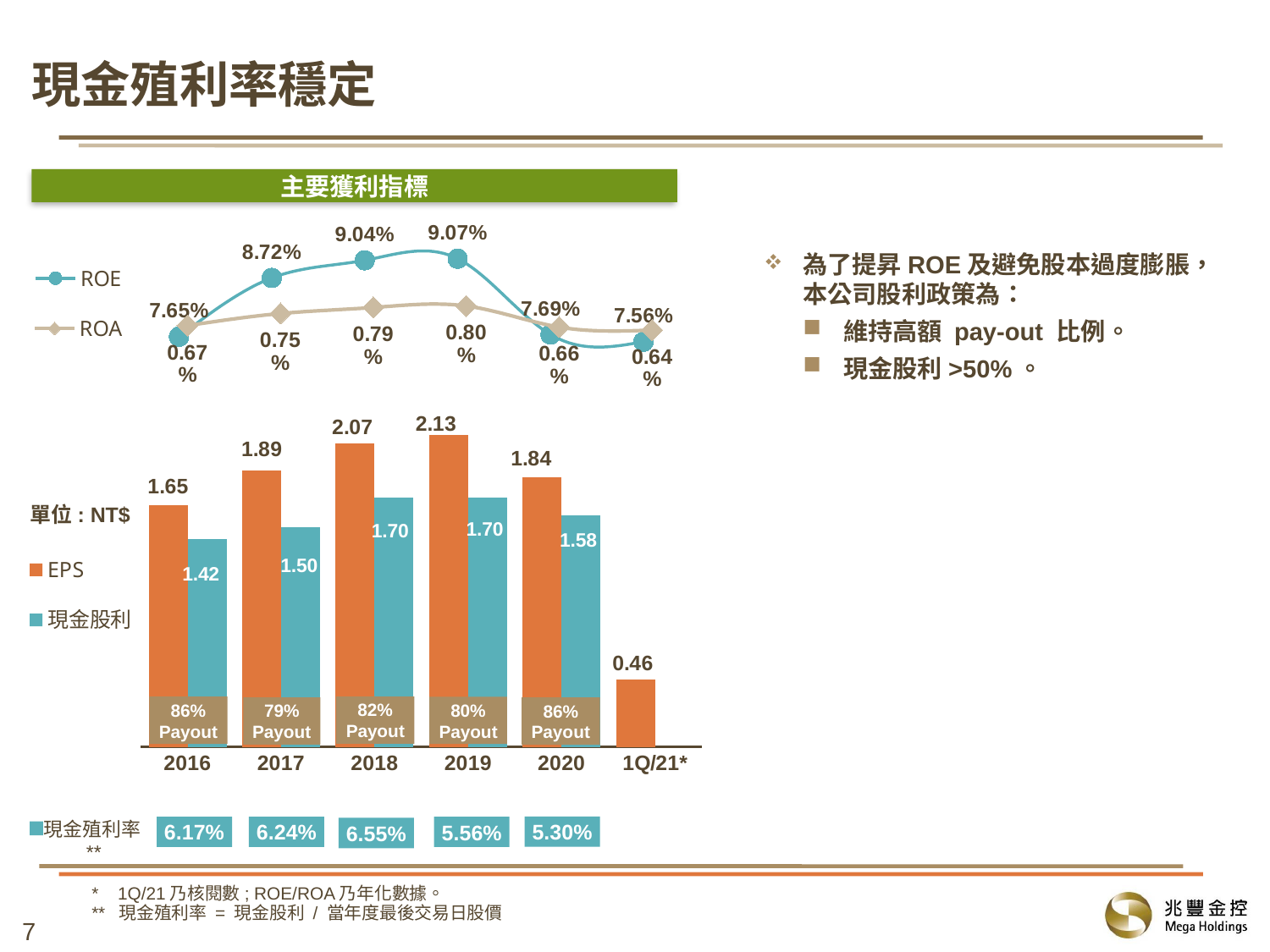
In the bottom bar chart, what is the EPS for 2018? 2.07 In the bottom bar chart, is the EPS for 2017 larger or smaller than the 現金股利 for 2017? larger In the bottom bar chart, which year has the highest EPS? 2019 In the bottom bar chart, what is the payout ratio shown for 2018? 82% Payout In the top line chart (主要獲利指標), what is the ROA value at the second point (2017)? 0.75% In the top line chart (主要獲利指標), what is the lowest ROA value shown? 0.64% In the top line chart (主要獲利指標), what is the ROE value at the fourth point (2019)? 9.07% In the top line chart (主要獲利指標), which point has the highest ROE? 2019 (9.07%) In the bottom bar chart, what is the 現金股利 (cash dividend) for 2020? 1.58 In the top line chart (主要獲利指標), how many series does the legend list? 2 In the bottom bar chart, what type of chart is used to show EPS and 現金股利? bar chart In the bottom bar chart, what is the difference between EPS and 現金股利 in 2016? 0.23